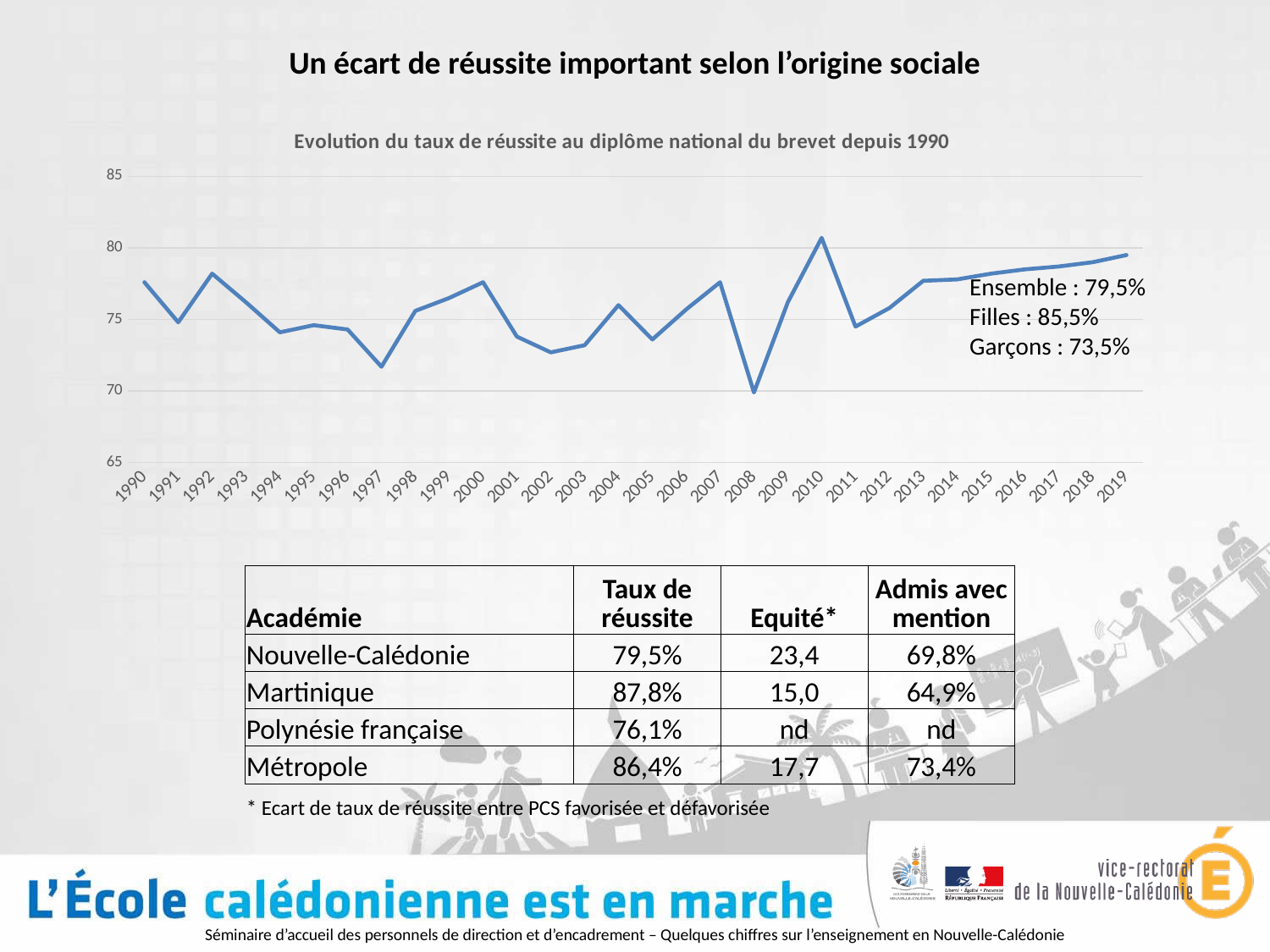
Which year has the highest success rate on the chart? 2010 Which year has the higher success rate, 2008 or 2010? 2010 What is the title of the chart? Evolution du taux de réussite au diplôme national du brevet depuis 1990 How many years are plotted along the x axis of the chart? 30 Is the value for 2008 greater or less than 75? less According to the annotation on the chart, what is the success rate for Filles? 85,5% Which year has the lowest success rate on the chart? 2008 Is the value for 2010 greater or less than 80? greater What kind of chart is shown on the slide? line chart Is the value for 1997 greater or less than 75? less Which year has the higher success rate, 1992 or 1994? 1992